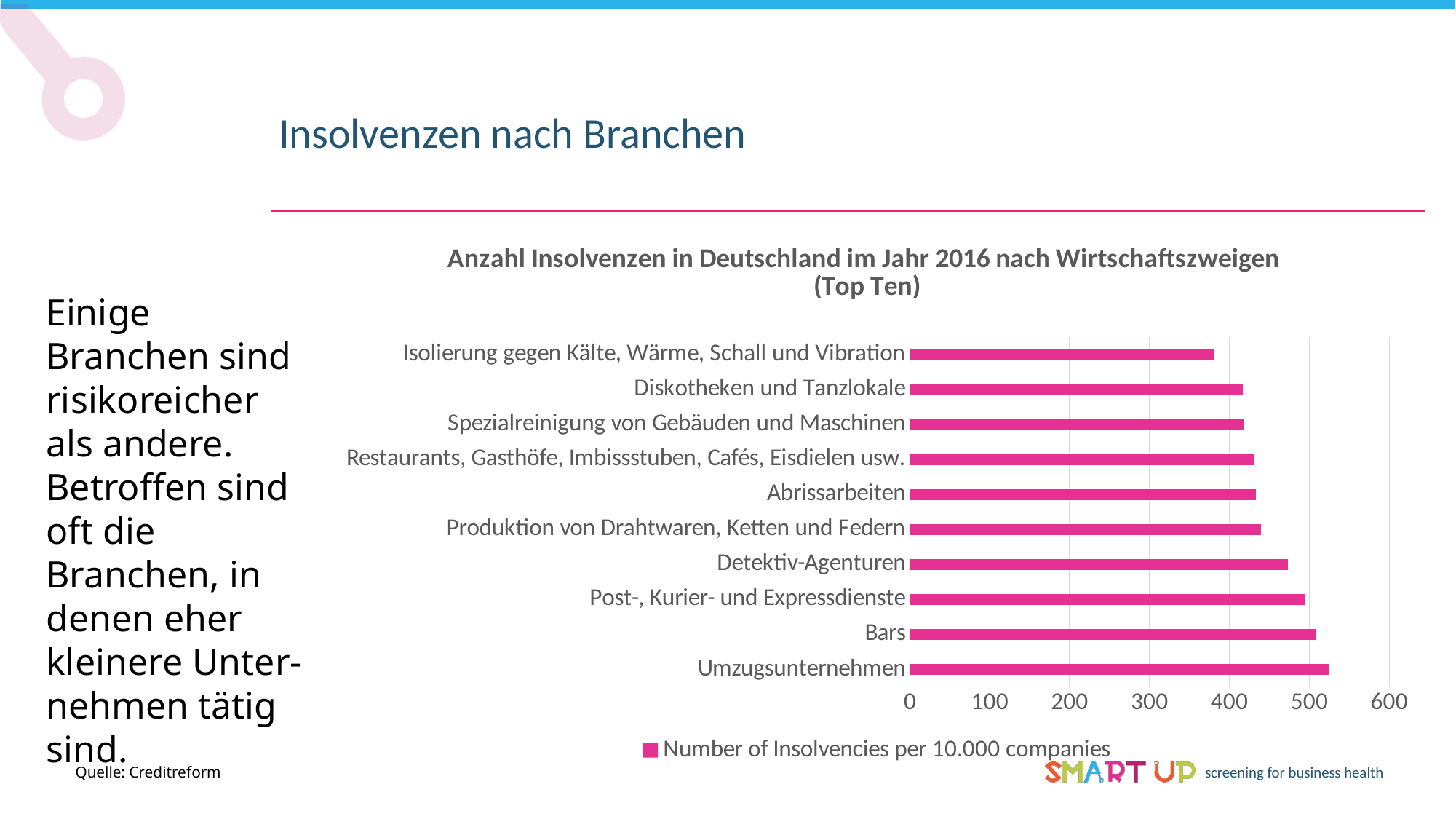
Is the value for Umzugsunternehmen greater or less than 500? greater Which category has the highest number of insolvencies per 10.000 companies? Umzugsunternehmen Which has a higher value, Abrissarbeiten or Detektiv-Agenturen? Detektiv-Agenturen Is the value for Isolierung gegen Kälte, Wärme, Schall und Vibration greater or less than 400? less Which has a higher value, Bars or Detektiv-Agenturen? Bars Is the value for Restaurants, Gasthöfe, Imbissstuben, Cafés, Eisdielen usw. greater or less than 500? less What kind of chart is shown on the slide? bar chart Which category has the lowest number of insolvencies per 10.000 companies? Isolierung gegen Kälte, Wärme, Schall und Vibration How many series does the chart legend list? 1 How many industry categories are plotted in the chart? 10 What is the legend entry of the series shown in the chart? Number of Insolvencies per 10.000 companies